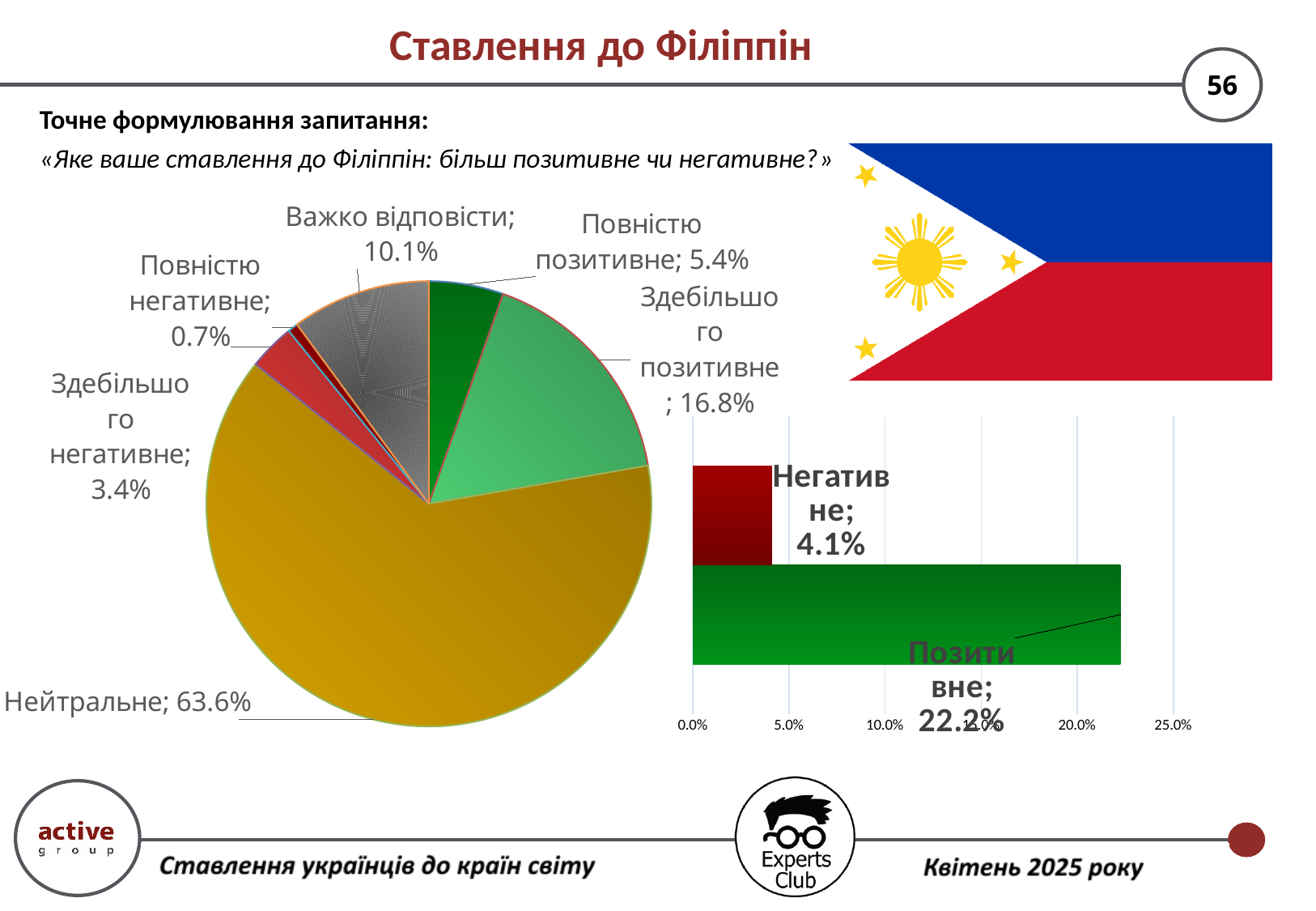
In the bar chart on the right, what is the difference between "Позитивне" and "Негативне"? 18.1% In the pie chart on the left, which is larger: "Здебільшого негативне" or "Повністю позитивне"? Повністю позитивне In the pie chart on the left, what is the value for "Важко відповісти"? 10.1% In the bar chart on the right, what is the value for "Негативне"? 4.1% In the pie chart on the left, what is the value for "Здебільшого позитивне"? 16.8% What kind of chart is shown on the right side of the slide? Bar chart In the pie chart on the left, which category has the largest share? Нейтральне In the pie chart on the left, which category has the smallest share? Повністю негативне In the bar chart on the right, what is the value for "Позитивне"? 22.2% In the pie chart on the left, how many slices are there? 6 In the pie chart on the left, what is the value for "Нейтральне"? 63.6% In the pie chart on the left, what is the difference between "Здебільшого позитивне" and "Повністю позитивне"? 11.4%